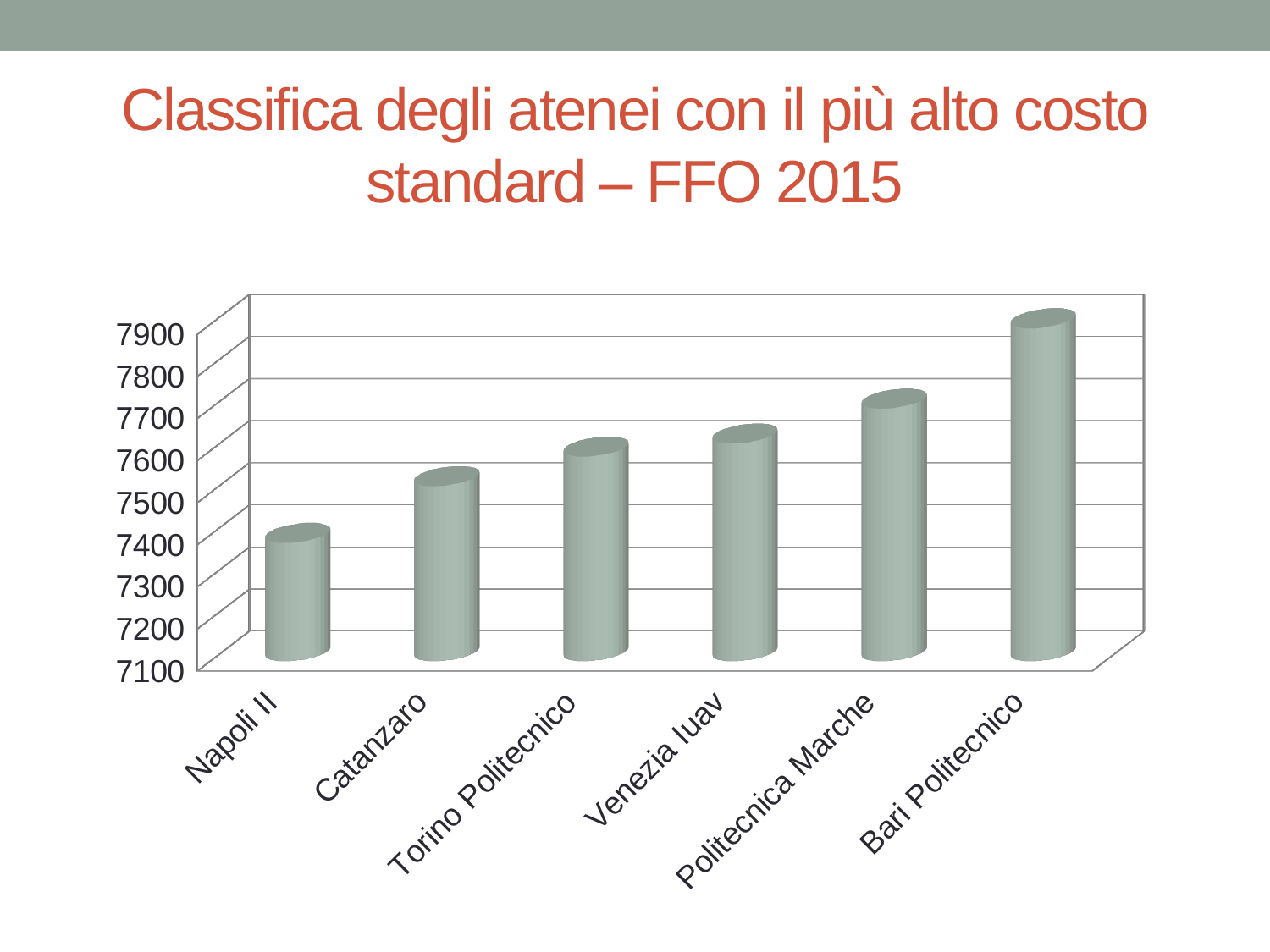
Which university has the lowest value on the chart? Napoli II Is the value for Napoli II greater or less than 7500? less Which university has the highest value on the chart? Bari Politecnico What is the title of the slide containing the chart? Classifica degli atenei con il più alto costo standard – FFO 2015 How many universities (categories) are shown on the chart? 6 Is the value for Politecnica Marche greater or less than 7600? greater Is the value for Bari Politecnico greater or less than 7800? greater What kind of chart is shown on the slide? Bar chart Which is larger, the value for Catanzaro or the value for Politecnica Marche? Politecnica Marche Do the values rise or fall moving from left to right along the x axis? Rise Which is larger, the value for Napoli II or the value for Bari Politecnico? Bari Politecnico